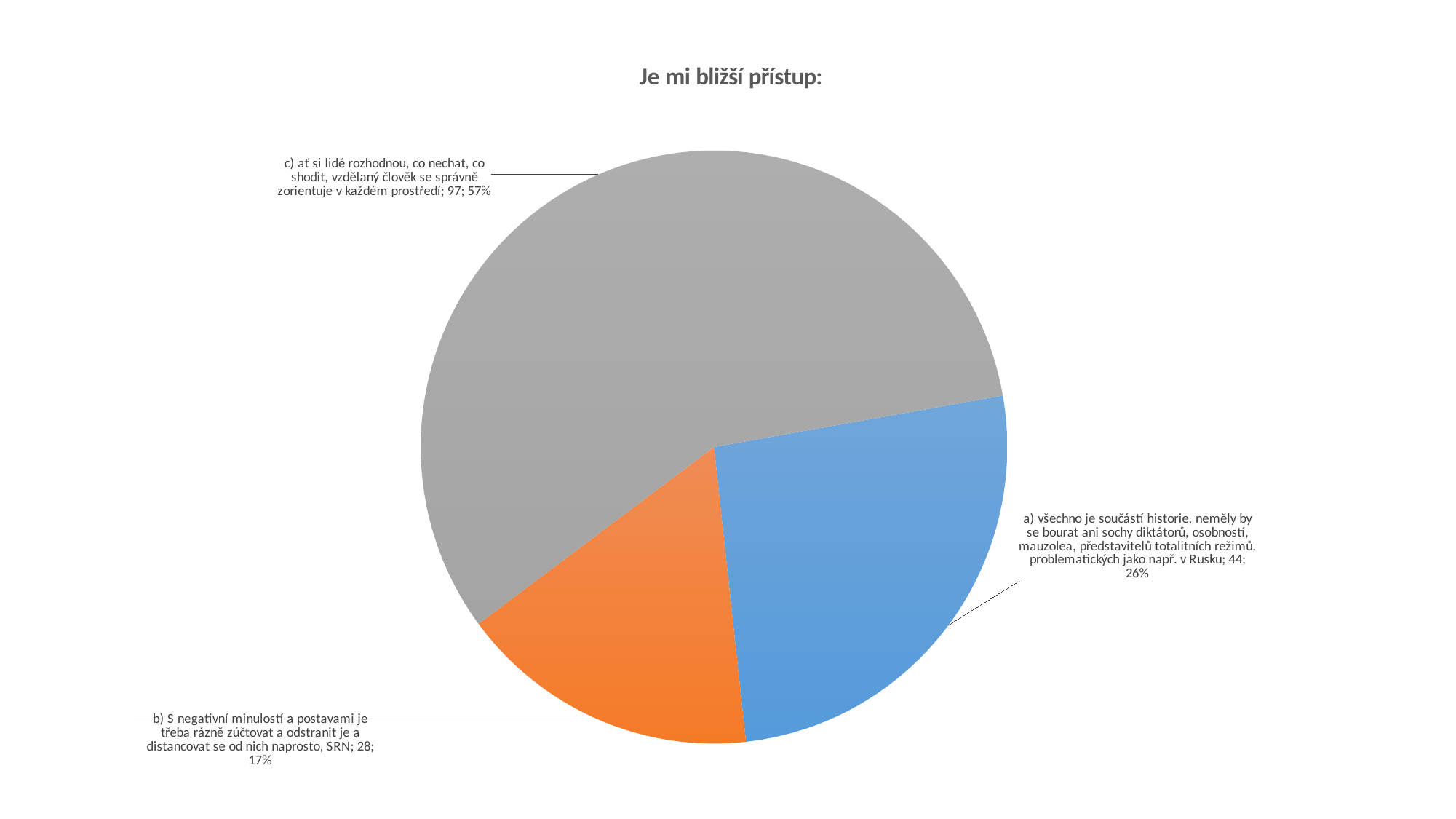
Which has a larger count, option a) or option b)? a) všechno je součástí historie What percentage share does option c) have? 57% Which option has the smallest slice? b) S negativní minulostí a postavami je třeba rázně zúčtovat a odstranit je a distancovat se od nich naprosto, SRN What colour is the slice for option b)? orange Which option has the largest slice? c) ať si lidé rozhodnou, co nechat, co shodit, vzdělaný člověk se správně zorientuje v každém prostředí What kind of chart is shown on the slide? pie chart What is the title of the chart? Je mi bližší přístup: What percentage share does option a) (všechno je součástí historie) have? 26% How many slices does the pie chart have? 3 What is the count for option c) (ať si lidé rozhodnou, co nechat, co shodit)? 97 What is the difference in count between option c) and option a)? 53 What is the count for option b) (S negativní minulostí a postavami je třeba rázně zúčtovat)? 28